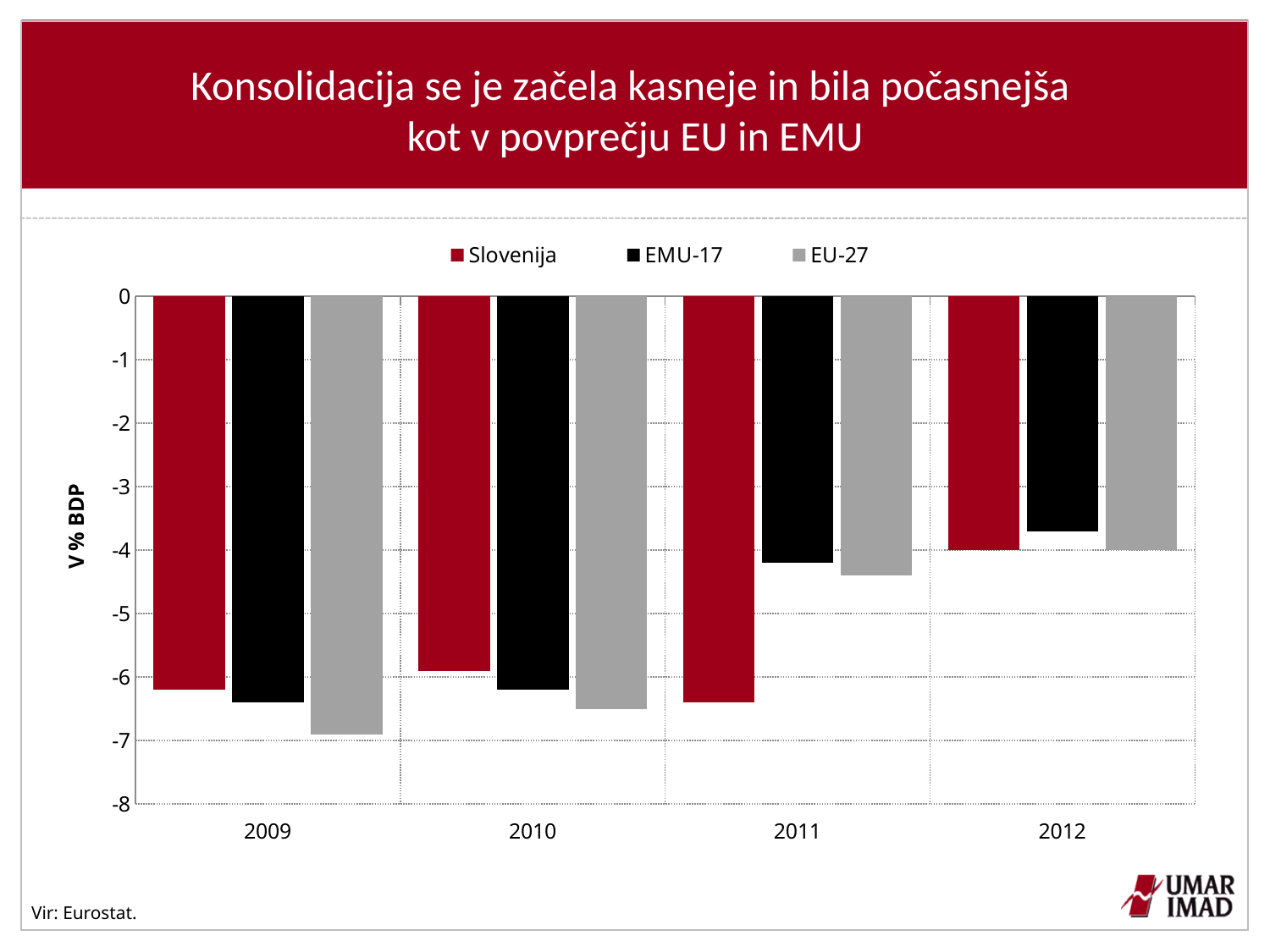
What colour are the bars for Slovenija? red Is the value for Slovenija in 2011 greater or less than -5? less In 2011, which has the higher (less negative) value, Slovenija or EMU-17? EMU-17 Which series and year has the lowest (most negative) value in the chart? EU-27 in 2009 What kind of chart is shown on the slide? bar chart In 2009, which has the lower (more negative) value, Slovenija or EU-27? EU-27 How many years are shown on the x axis? 4 Is the value for EMU-17 in 2012 greater or less than -4? greater Which series has the highest (least negative) value in 2012? EMU-17 How many series does the legend list? 3 What is the label on the vertical axis? V % BDP Do the values for EMU-17 rise or fall from 2009 to 2012? rise